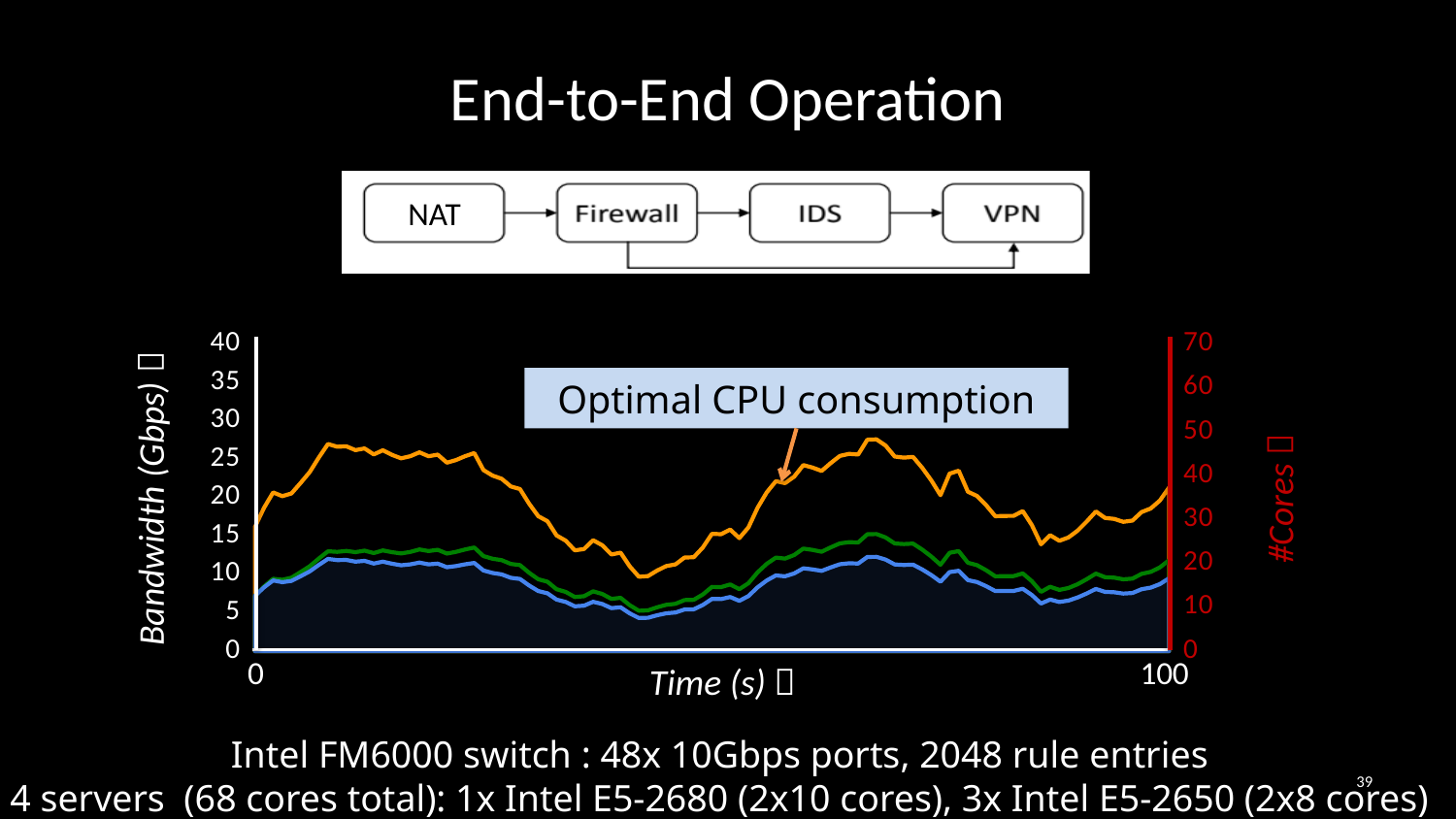
What is the title of the left y-axis of the chart? Bandwidth (Gbps) Is the peak value of the green line greater or less than 20 on the left axis? less What is the title of the right y-axis of the chart? #Cores What kind of chart is shown on the slide? area chart How many lines are plotted on the chart? 3 Does the blue line rise or fall between time 0 and time 20? rise Is the peak value of the blue line greater or less than 15 on the left axis? less Does the orange line rise or fall between time 20 and time 50? fall Does the orange line rise or fall between time 50 and time 70? rise Is the value of the blue line at time 0 greater or less than 10 on the left axis? less